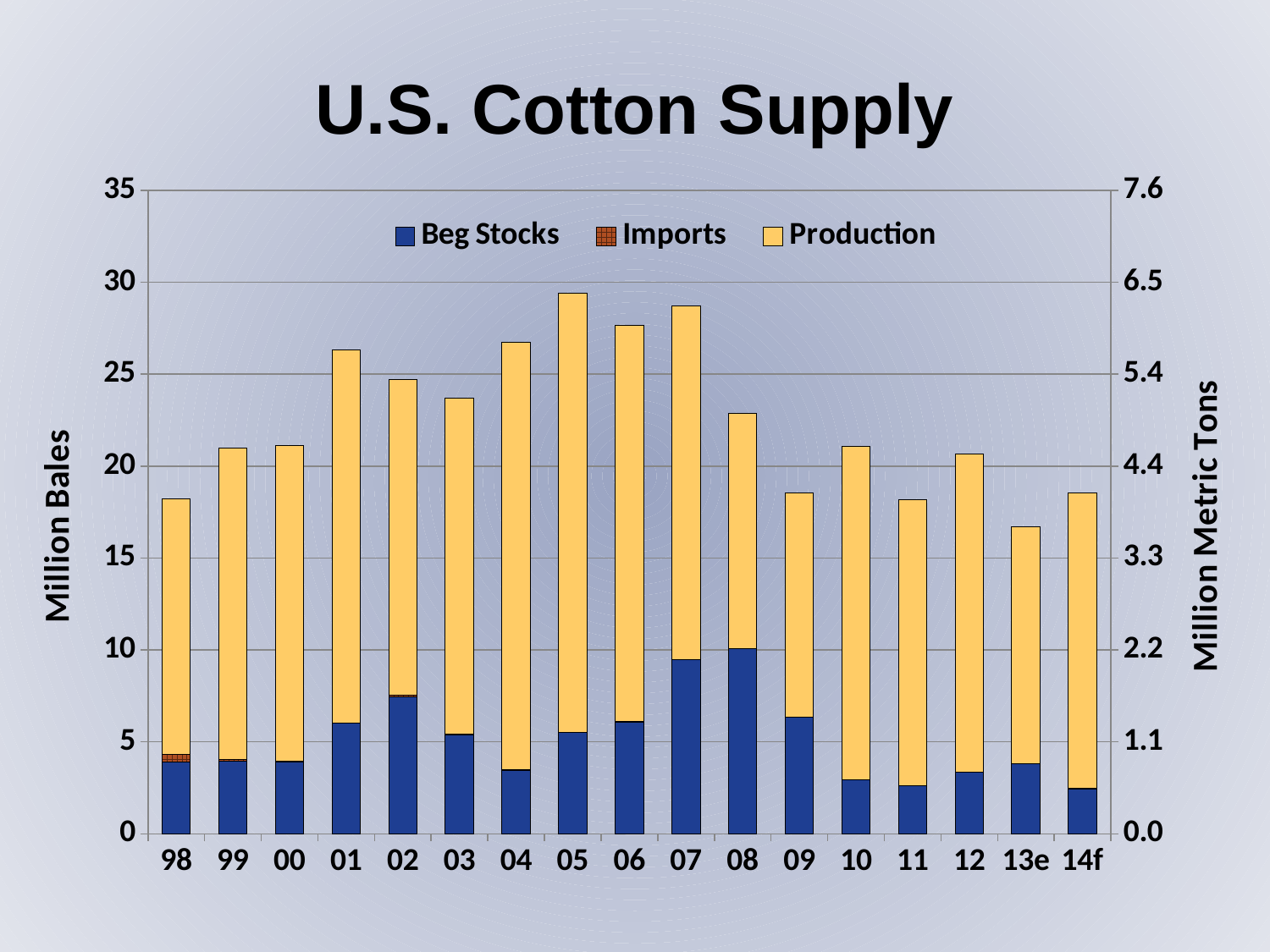
Which year has the highest total U.S. cotton supply? 05 How many years (categories) are shown on the x axis? 17 Which year has the lowest total U.S. cotton supply? 13e What kind of chart is shown on the slide? Stacked bar chart Which year has a larger total supply, 01 or 09? 01 How many series does the legend list? 3 Is the total supply for 05 greater or less than 25 million bales? greater Is the Beg Stocks value for 08 greater or less than 5 million bales? greater What is the title of the left vertical axis? Million Bales Which year has the largest Beg Stocks segment? 08 Is the total supply for 13e greater or less than 20 million bales? less Does the total supply rise or fall from 98 to 01? rise